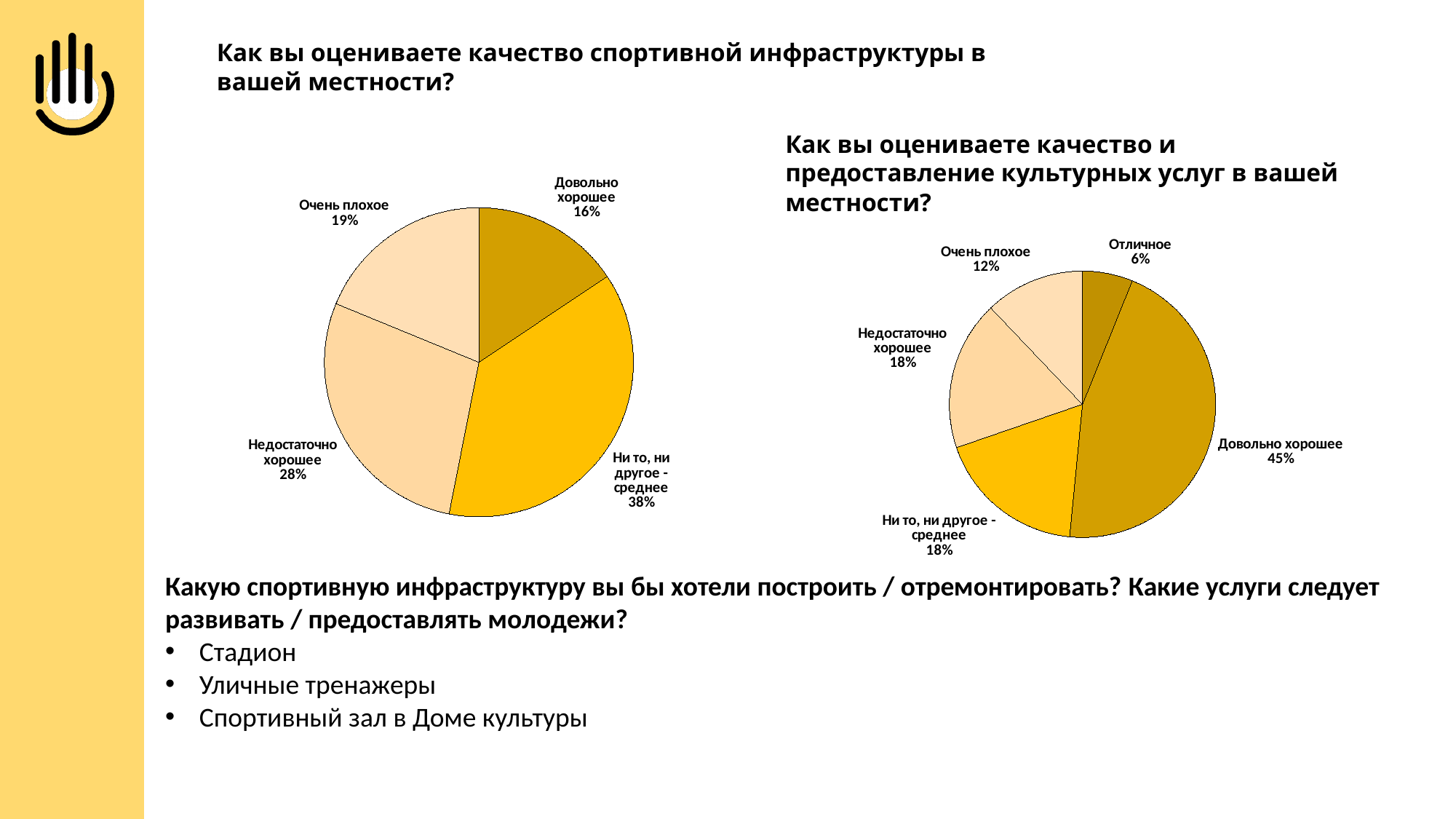
In the left pie chart (sports infrastructure quality), how many slices does the pie have? 4 In the right pie chart (cultural services quality), how many slices does the pie have? 5 What type of chart is used for both charts on the slide? Pie chart In the left pie chart (sports infrastructure quality), what is the difference between the shares for "Недостаточно хорошее" and "Довольно хорошее"? 12% In the left pie chart (sports infrastructure quality), which category has the largest share? Ни то, ни другое - среднее In the right pie chart (cultural services quality), which category has the smallest share? Отличное In the right pie chart (cultural services quality), what share is labelled "Довольно хорошее"? 45% In the left pie chart (sports infrastructure quality), which category has the smallest share? Довольно хорошее In the right pie chart (cultural services quality), which is larger: "Очень плохое" or "Недостаточно хорошее"? Недостаточно хорошее In the left pie chart (sports infrastructure quality), what share is labelled "Ни то, ни другое - среднее"? 38% In the right pie chart (cultural services quality), what share is labelled "Отличное"? 6% In the left pie chart (sports infrastructure quality), what share is labelled "Очень плохое"? 19%